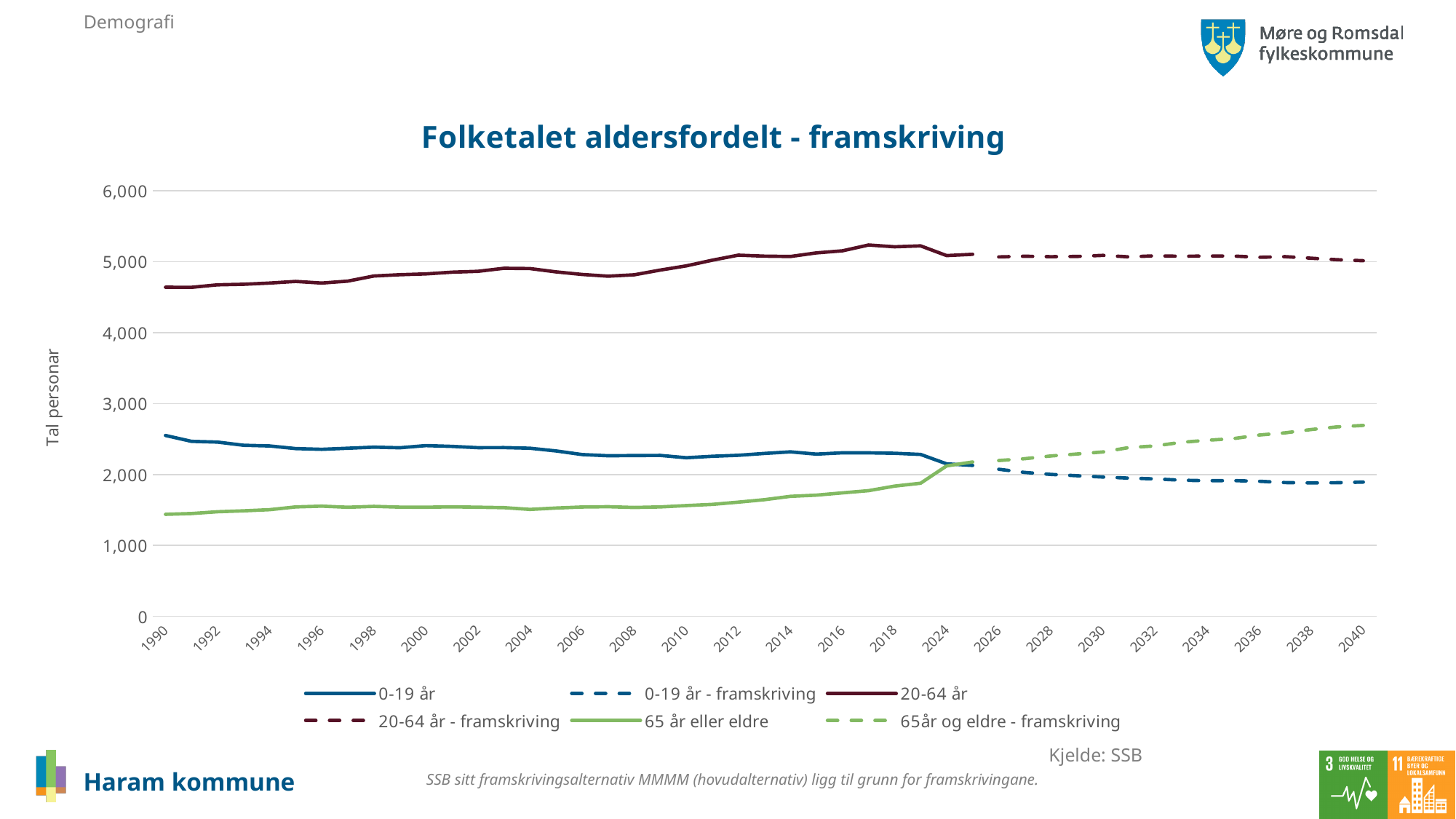
What kind of chart is shown on the slide? line chart How many series does the legend list? 6 Which series has the lowest value in 1990? 65 år eller eldre What is the title of the chart? Folketalet aldersfordelt - framskriving In 2040, which is larger: 65år og eldre - framskriving or 0-19 år - framskriving? 65år og eldre - framskriving What is the label on the vertical axis? Tal personar Is the value for 0-19 år - framskriving in 2040 greater or less than 2,000? less Is the value for 65år og eldre - framskriving in 2040 greater or less than 2,000? greater Is the value for 65 år eller eldre in 1990 greater or less than 2,000? less Does the 65 år eller eldre series rise or fall from 1990 to 2024? rise